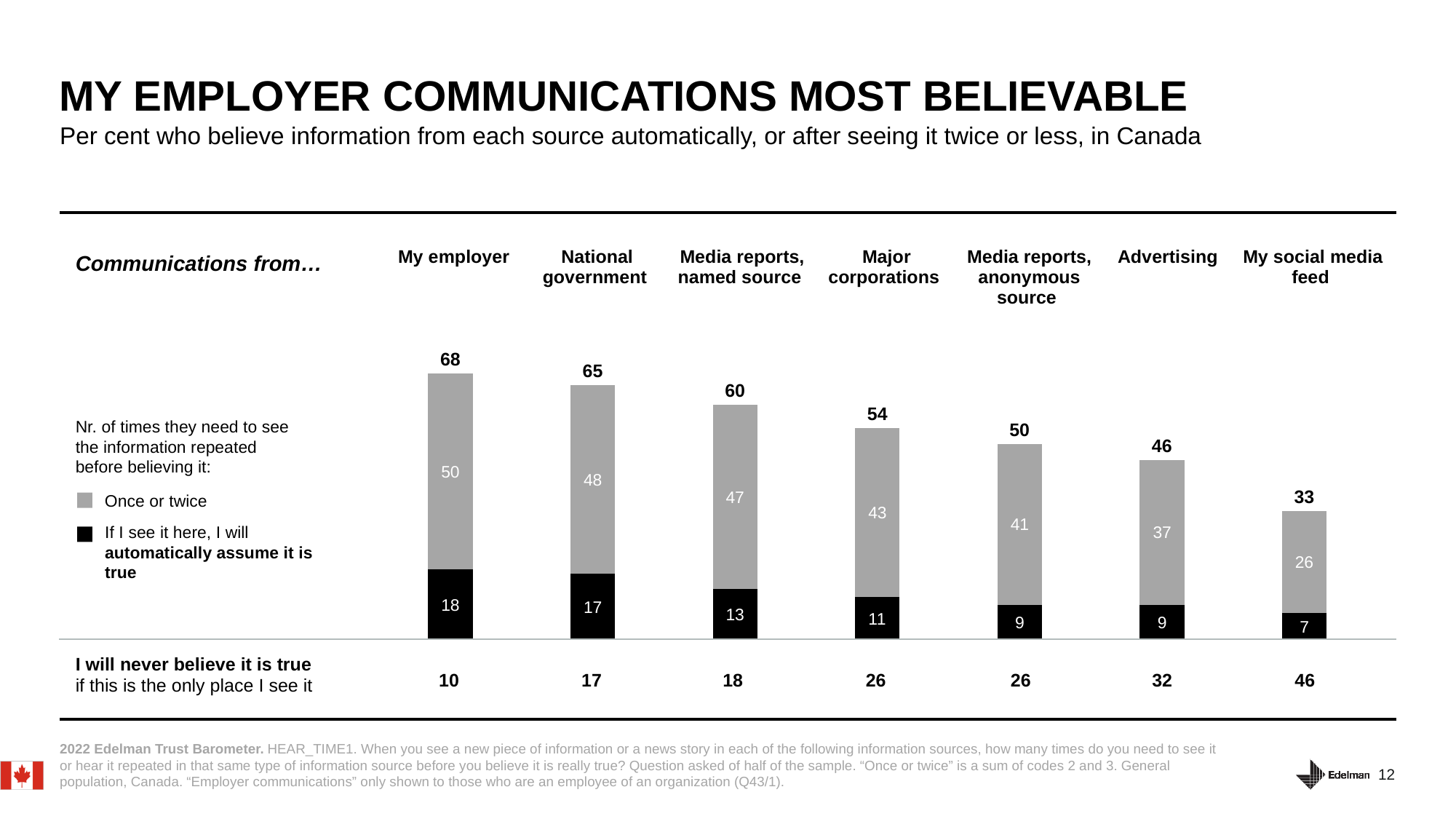
Which is larger: the 'Once or twice' value for Media reports, anonymous source or for Advertising? Media reports, anonymous source How many sources (categories) are shown in the chart? 7 How many series does the legend list for the stacked bars? 2 What is the total stacked bar value for My employer? 68 Which source has the highest 'automatically assume it is true' value? My employer What is the difference between the total for National government and the total for Advertising? 19 What kind of chart is shown on the slide? Stacked bar chart Which source has the lowest total stacked bar value? My social media feed Do the total stacked bar values rise or fall from left to right across the sources? Fall What is the 'Once or twice' value for Media reports, named source? 47 What is the 'automatically assume it is true' value for Major corporations? 11 What is the 'I will never believe it is true' value for My social media feed? 46